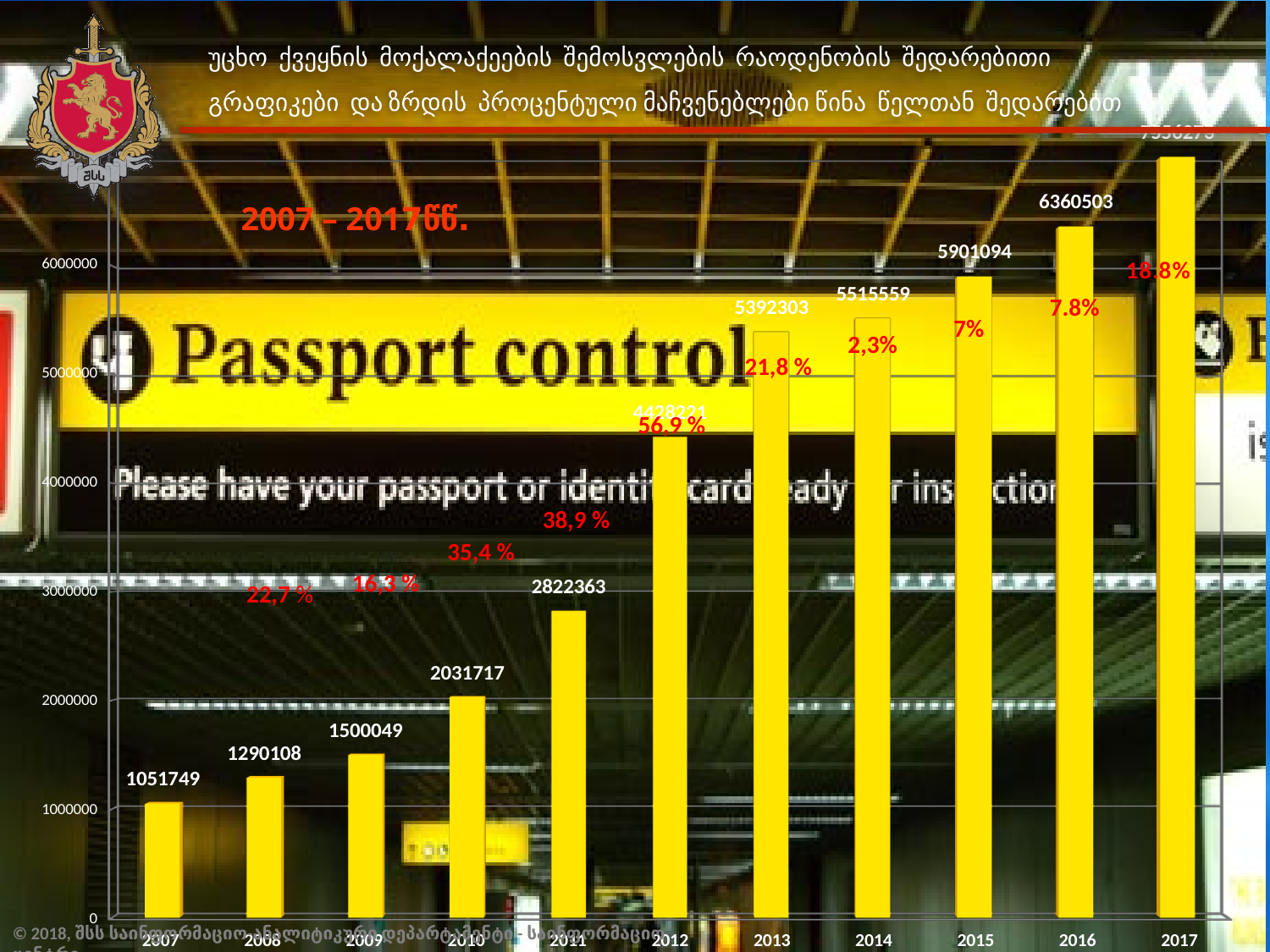
What is the difference between the values for 2016 and 2015? 459409 Is the value for 2012 greater or less than 4000000? greater How many years are shown on the x axis? 11 Which year has the highest value? 2017 Do the values rise or fall from 2007 to 2017? rise Which year has the larger value, 2009 or 2010? 2010 What is the value shown for 2016? 6360503 Which year has the lowest value? 2007 What is the value shown for 2011? 2822363 What is the value shown for 2014? 5515559 What kind of chart is shown on the slide? bar chart What is the value shown for 2007? 1051749